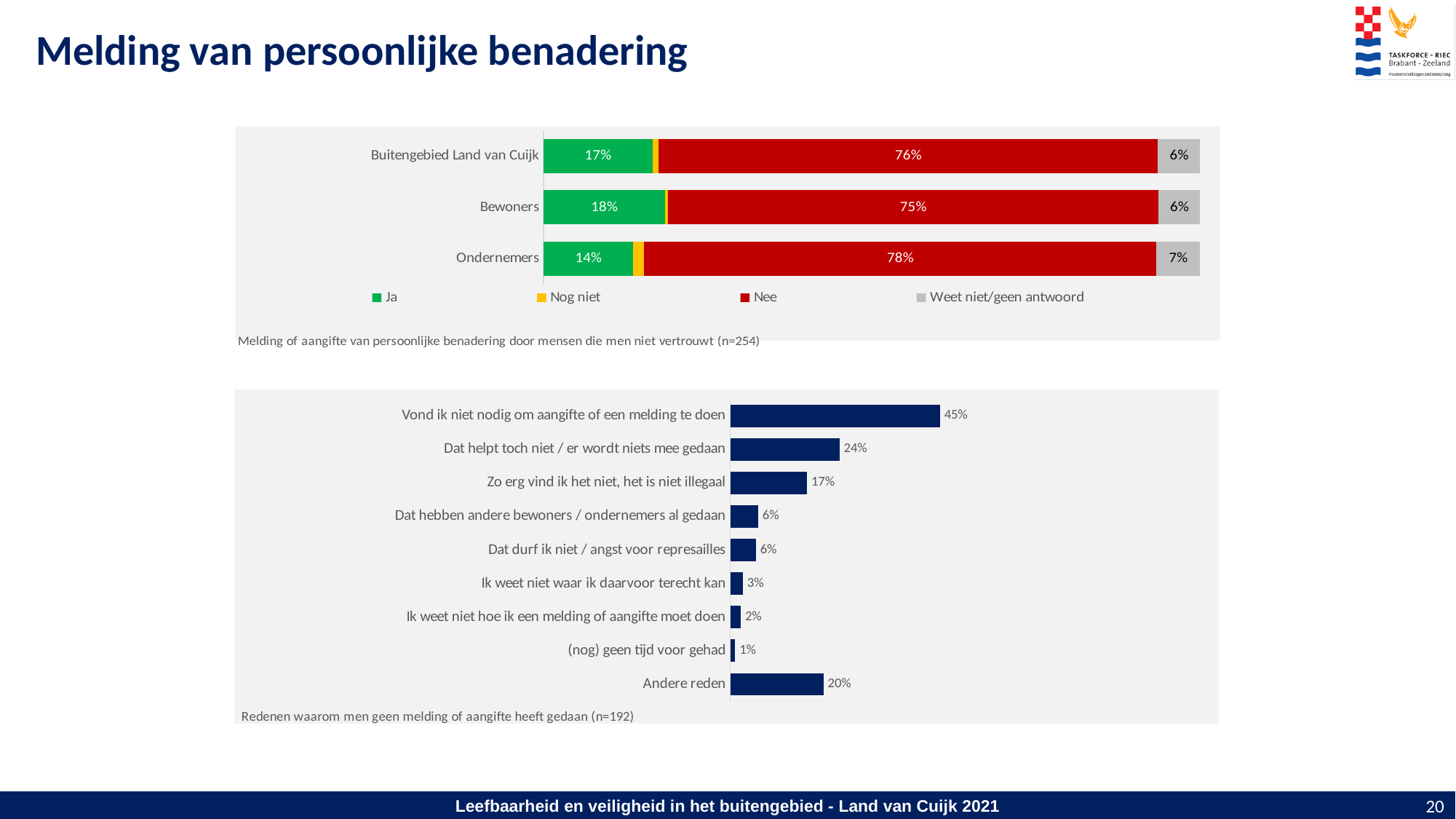
In the top chart, what is the 'Ja' value for Bewoners? 18% In the top chart, how many series does the legend list? 4 In the bottom chart, which reason has the lowest value? (nog) geen tijd voor gehad In the bottom chart, how many reasons are listed? 9 In the top chart, what is the 'Weet niet/geen antwoord' value for Buitengebied Land van Cuijk? 6% In the top chart, what is the difference between the 'Nee' values for Ondernemers and Bewoners? 3% In the bottom chart, which reason has the highest value? Vond ik niet nodig om aangifte of een melding te doen What kind of chart is the bottom chart? Bar chart In the top chart, which category has the lowest 'Ja' value? Ondernemers In the top chart (Melding of aangifte van persoonlijke benadering), what is the 'Nee' value for Ondernemers? 78% In the bottom chart (Redenen waarom men geen melding of aangifte heeft gedaan), what is the value for 'Dat helpt toch niet / er wordt niets mee gedaan'? 24% In the bottom chart, which is larger: 'Andere reden' or 'Zo erg vind ik het niet, het is niet illegaal'? Andere reden